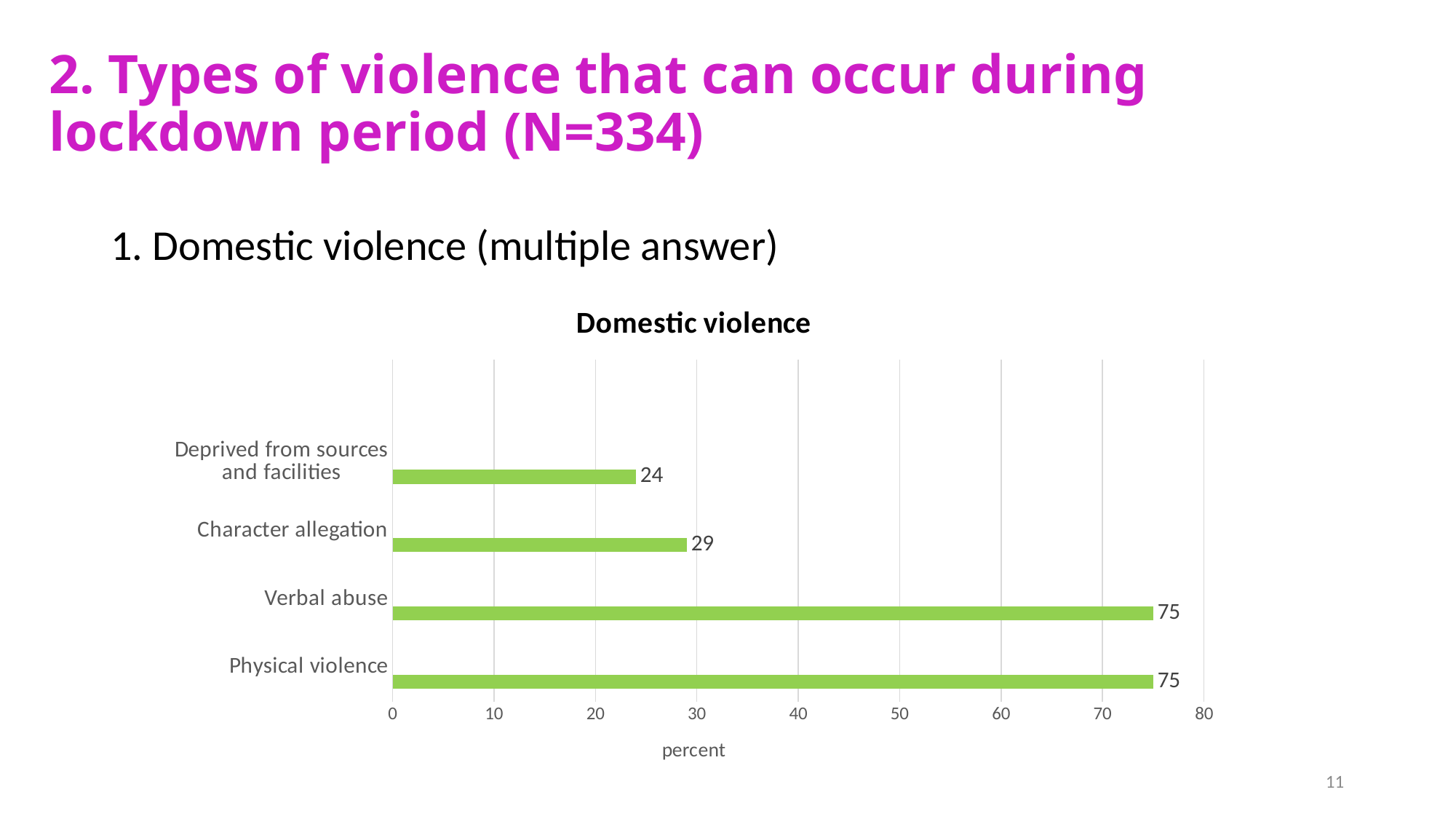
What is the value for Verbal abuse? 75 What is the value for Physical violence? 75 What is the difference between the values for Character allegation and Deprived from sources and facilities? 5 What is the value for Character allegation? 29 Is the value for Physical violence greater or less than 70? greater Which category has the lowest value? Deprived from sources and facilities What kind of chart is shown on the slide? bar chart Which is larger, the value for Character allegation or the value for Deprived from sources and facilities? Character allegation What is the value for Deprived from sources and facilities? 24 What is the title of the chart? Domestic violence What is the difference between the values for Verbal abuse and Character allegation? 46 How many categories are shown in the chart? 4